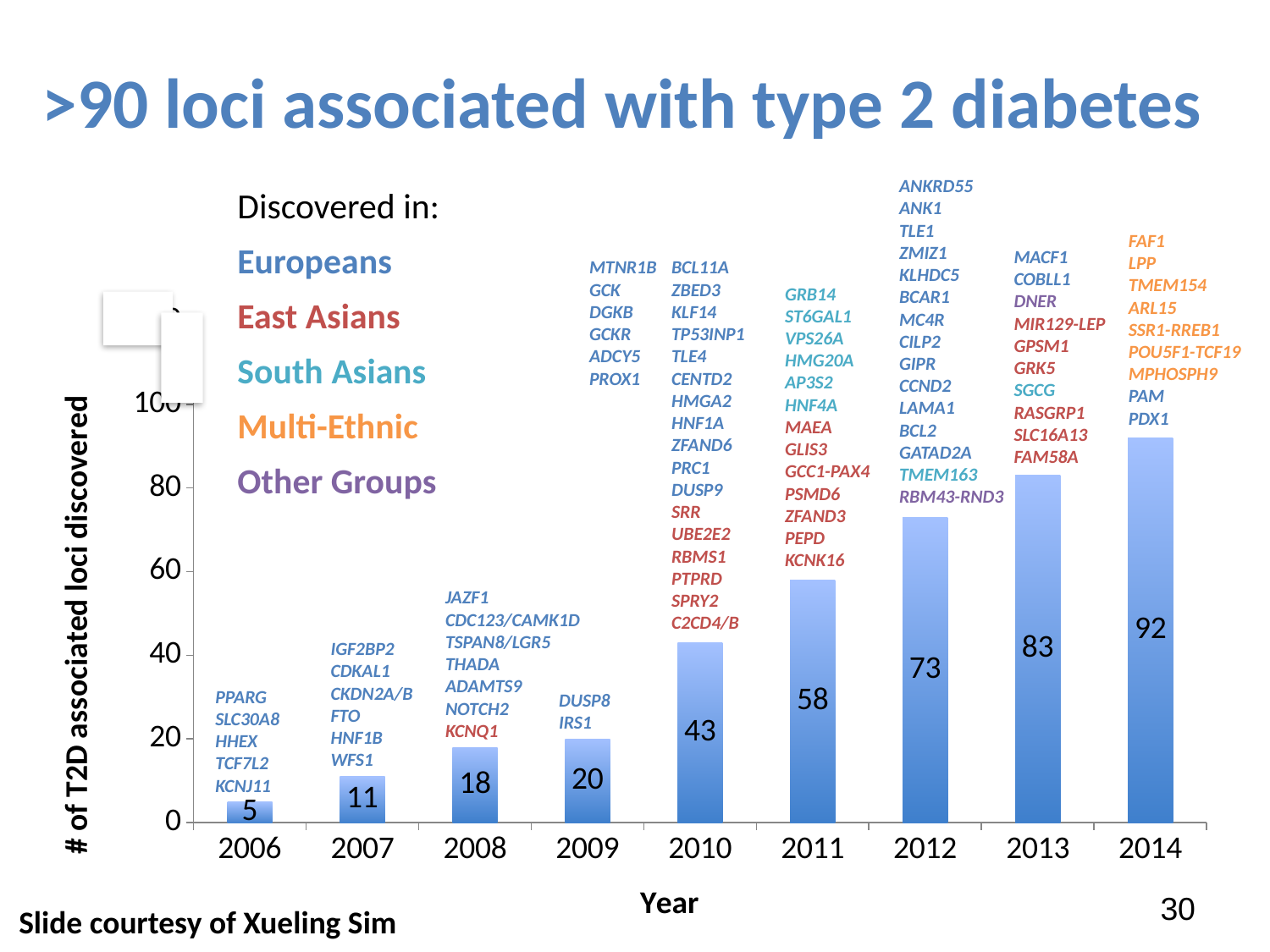
Which year has the lowest number of T2D associated loci discovered? 2006 What is the number of T2D associated loci discovered in 2013? 83 Do the values rise or fall from 2006 to 2014? rise What kind of chart is shown on the slide? bar chart What is the difference between the number of loci discovered in 2014 and in 2013? 9 What is the difference between the number of loci discovered in 2011 and in 2010? 15 Which year has a larger number of loci discovered, 2008 or 2009? 2009 Which year has the highest number of T2D associated loci discovered? 2014 How many years are shown on the x axis of the chart? 9 What is the number of T2D associated loci discovered in 2006? 5 What is the number of T2D associated loci discovered in 2010? 43 What is the label of the y axis of the chart? # of T2D associated loci discovered